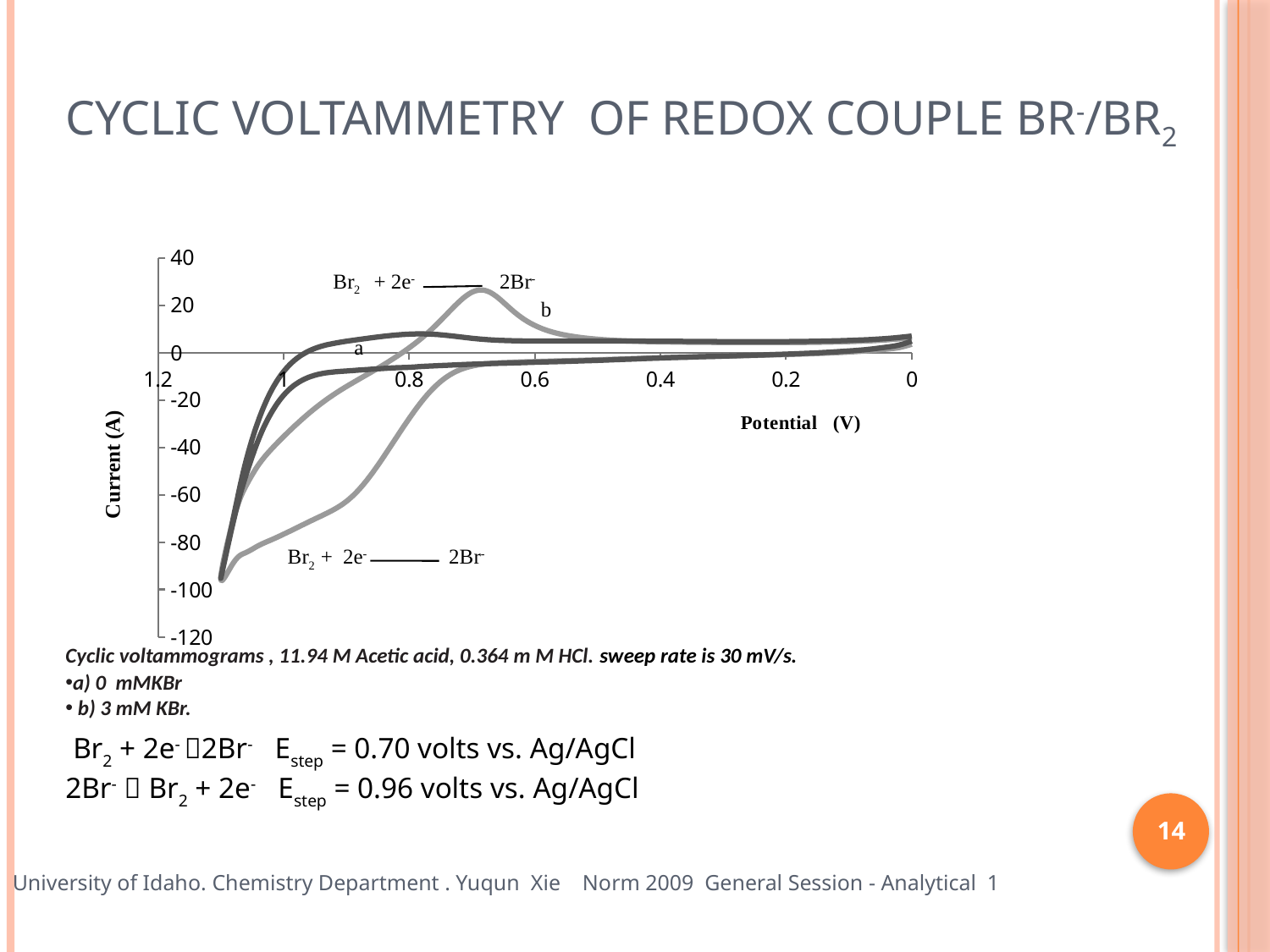
Is the peak current of curve b greater or less than 40? less Is the peak current of curve b greater or less than 20? greater What kind of chart is shown on the slide? line chart What is the highest tick value shown on the y axis? 40 Which curve, a or b, reaches the higher peak current? b Is the lowest current reached by the curves near 1.2 V greater or less than -80? less What is the label of the y axis of the chart? Current (A) How many curves are plotted on the chart? 2 What is the label of the x axis of the chart? Potential (V)